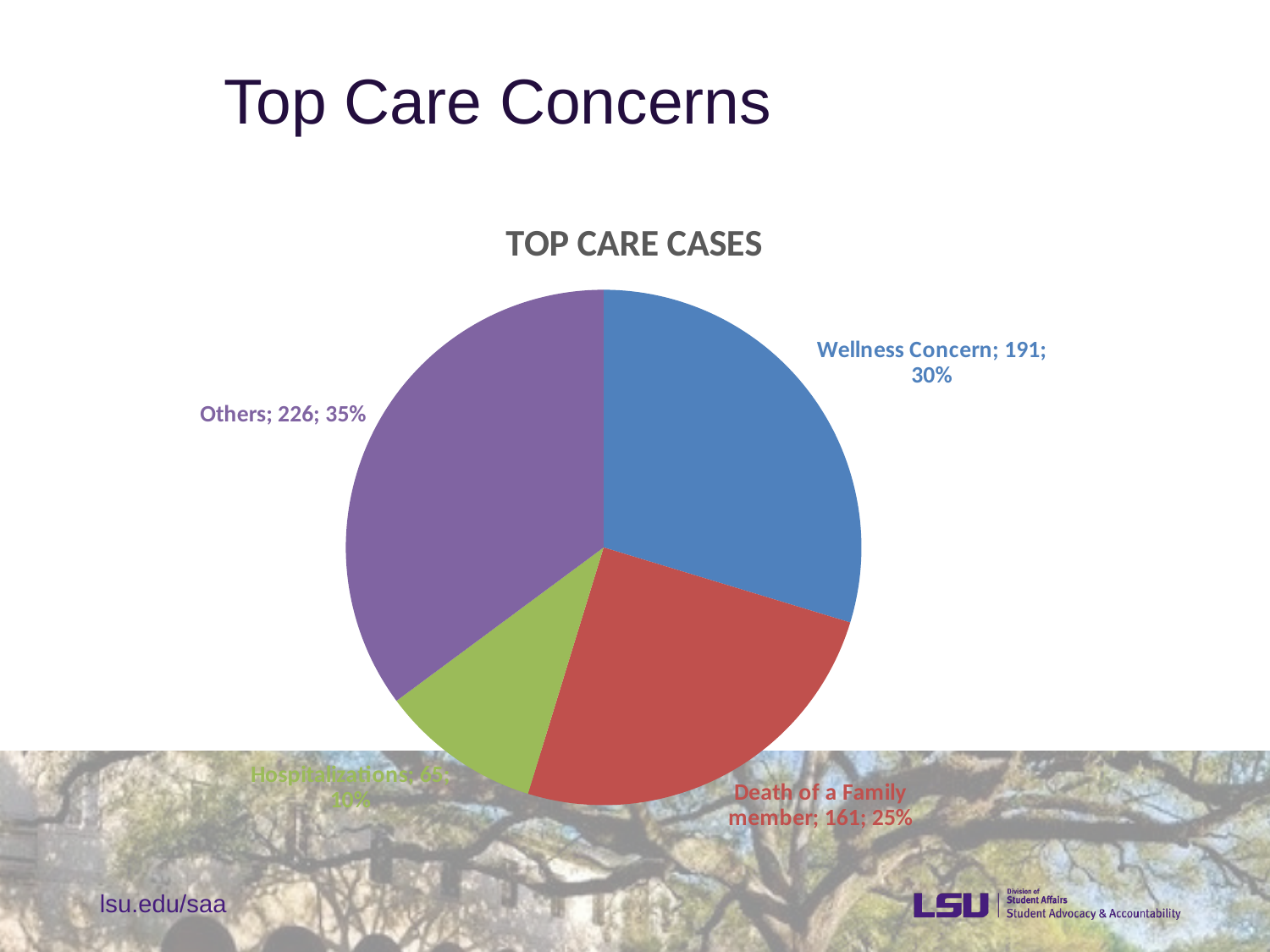
Which has more cases, Wellness Concern or Death of a Family member? Wellness Concern How many cases are labelled for Wellness Concern? 191 How many slices does the pie chart have? 4 What is the difference in cases between Others and Wellness Concern? 35 What percentage share of the pie is Others? 35% What type of chart is shown on the slide? pie chart What is the title of the chart? TOP CARE CASES How many cases are labelled for Death of a Family member? 161 Which category has the largest slice of the pie? Others What percentage share of the pie is Death of a Family member? 25% Which category has the smallest slice of the pie? Hospitalizations How many cases are labelled for Others? 226